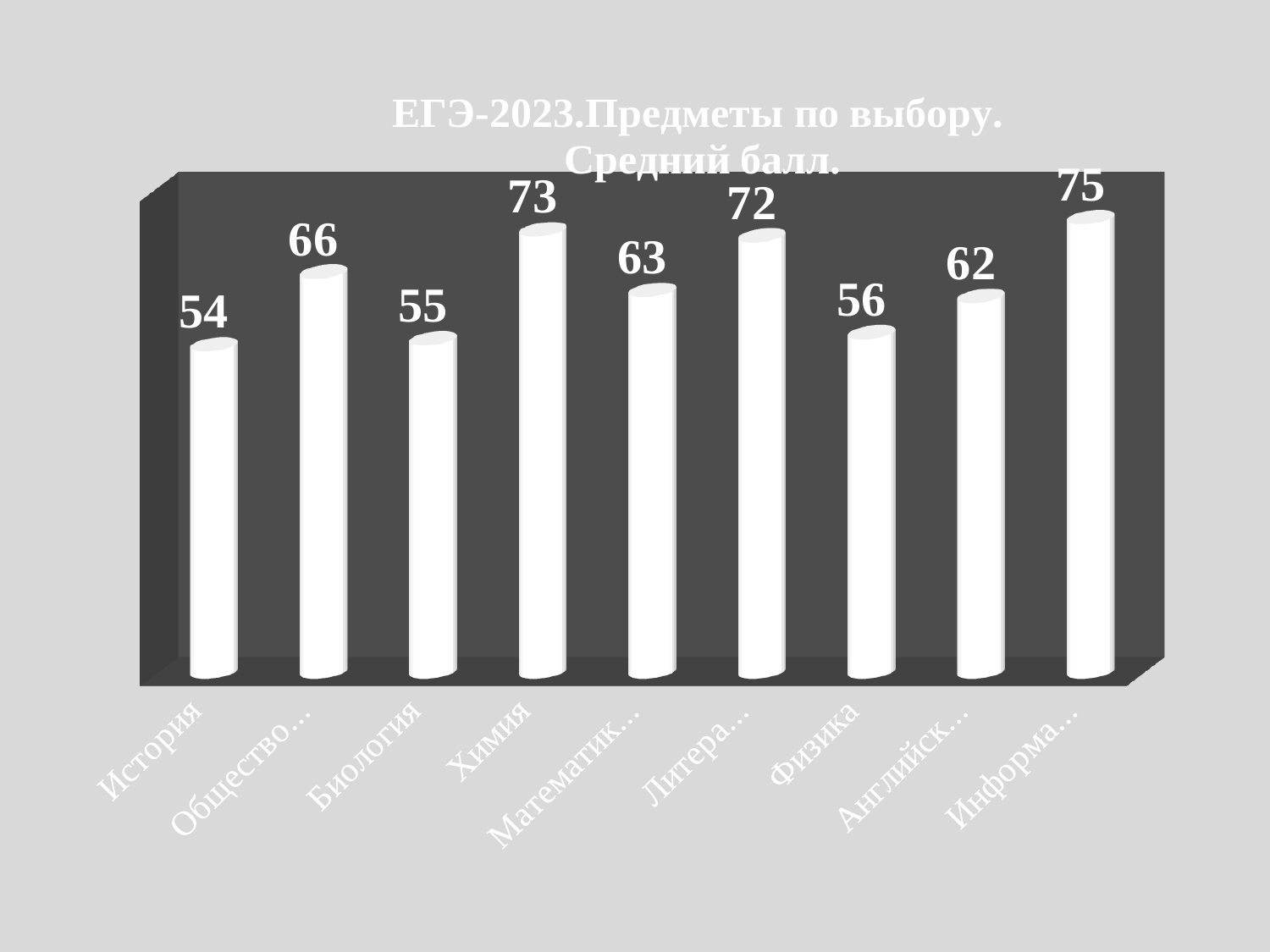
What is the value for История? 54 What kind of chart is shown on the slide? bar chart What is the difference between the values for Химия and История? 19 What is the title of the chart? ЕГЭ-2023.Предметы по выбору. Средний балл. What is the value for Физика? 56 Which is larger, the value for Химия or the value for Физика? Химия What is the value for Биология? 55 What is the value of the highest bar, the rightmost one? 75 How many bars are shown in the chart? 9 What is the value for Химия? 73 What is the difference between the values for Физика and Биология? 1 Which category has the lowest value? История